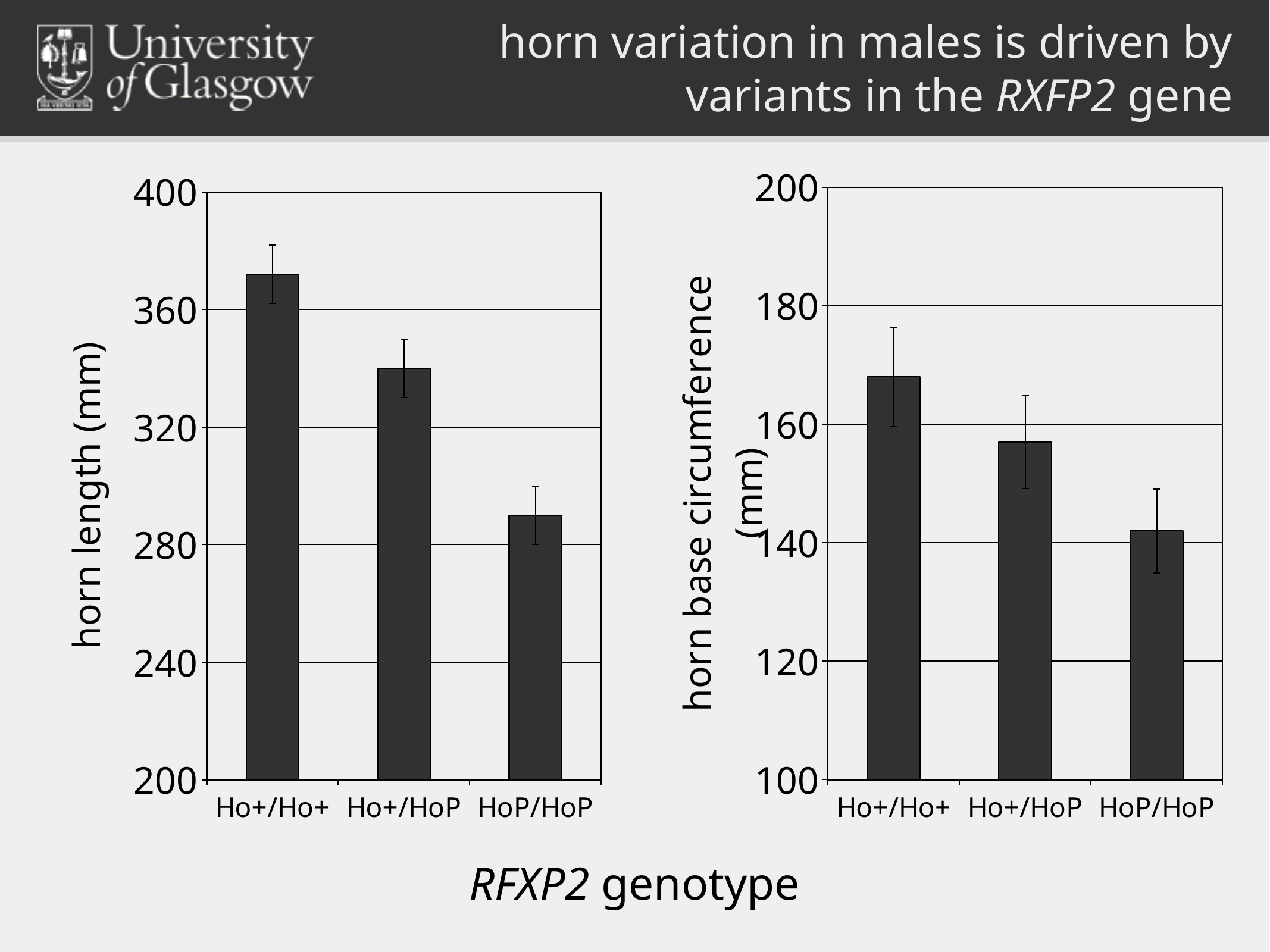
On the right chart (horn base circumference), is the value for Ho+/Ho+ greater or less than 160? greater On the right chart (horn base circumference), which genotype has the highest value? Ho+/Ho+ On the left chart (horn length), is the value for Ho+/HoP greater or less than 320? greater On the left chart (horn length), is the value for Ho+/Ho+ greater or less than 360? greater On the right chart (horn base circumference), which genotype has the lowest value? HoP/HoP On the right chart (horn base circumference), do the values rise or fall from Ho+/Ho+ to HoP/HoP along the x axis? fall How many genotype categories are plotted on the left chart (horn length)? 3 What kind of chart is the left chart showing horn length? bar chart What is the x-axis label shared by both charts? RFXP2 genotype On the left chart (horn length), which genotype has the lowest horn length? HoP/HoP On the left chart (horn length), which genotype has the highest horn length? Ho+/Ho+